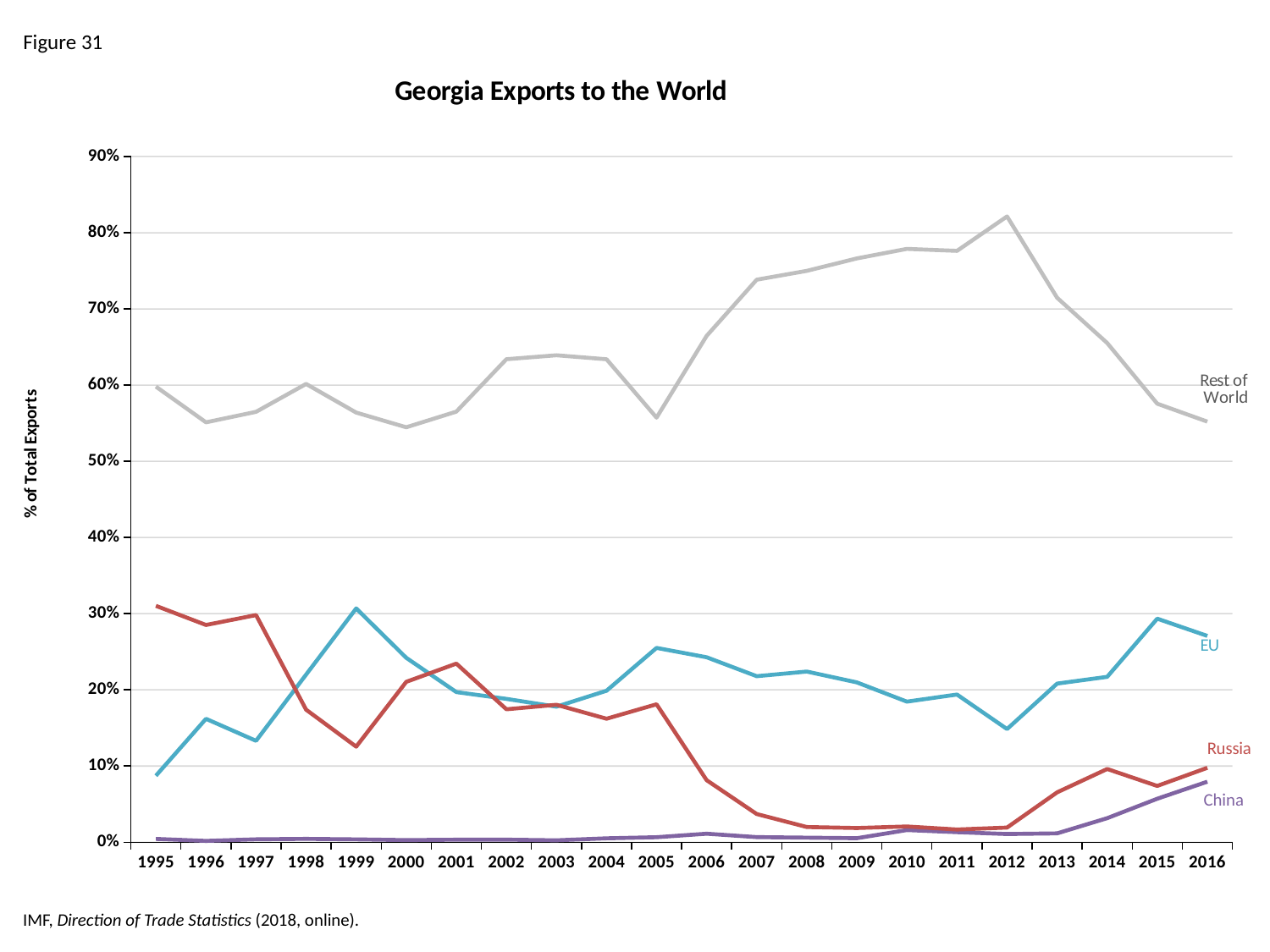
Is the value for EU in 2012 greater or less than 20%? less Does the China series rise or fall from 2012 to 2016? rise Is the value for Rest of World in 2012 greater or less than 80%? greater What is the title of the chart? Georgia Exports to the World How many series are plotted in the chart? 4 Is the value for Russia in 2008 greater or less than 10%? less In 1995, which is larger: the value for Russia or the value for EU? Russia What is the label of the y axis? % of Total Exports In which year does the Rest of World series reach its highest value? 2012 How many years are shown on the x axis? 22 What kind of chart is shown on the slide? line chart Which series has the lowest values across the whole period? China